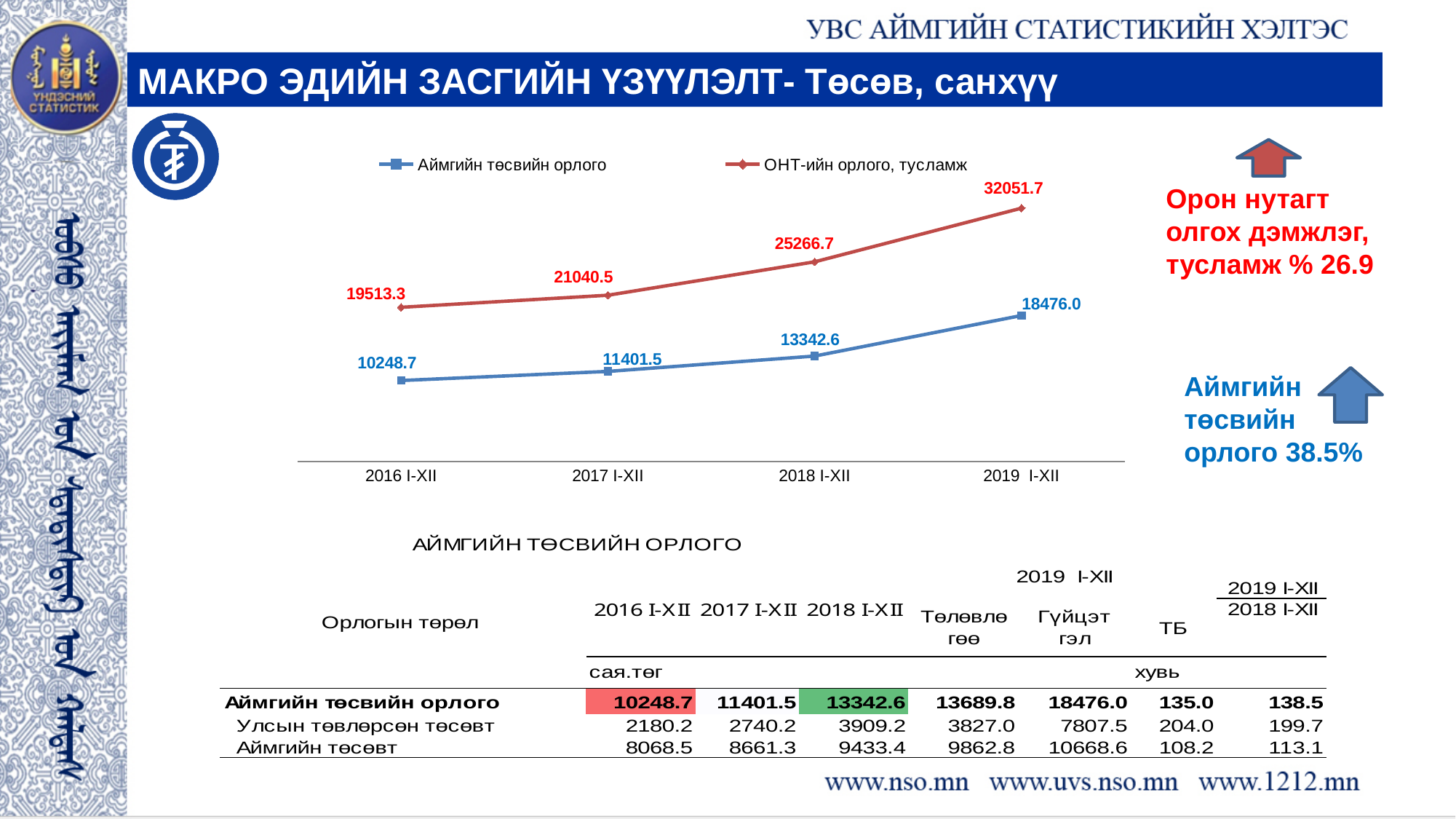
What type of chart is shown on the slide? line chart Which series has the larger value in 2018 I-XII, Аймгийн төсвийн орлого or ОНТ-ийн орлого, тусламж? ОНТ-ийн орлого, тусламж What is the value of Аймгийн төсвийн орлого for 2016 I-XII? 10248.7 What is the value of ОНТ-ийн орлого, тусламж for 2017 I-XII? 21040.5 What is the value of ОНТ-ийн орлого, тусламж for 2019 I-XII? 32051.7 What is the value of Аймгийн төсвийн орлого for 2018 I-XII? 13342.6 What is the difference between ОНТ-ийн орлого, тусламж and Аймгийн төсвийн орлого in 2019 I-XII? 13575.7 Does Аймгийн төсвийн орлого rise or fall from 2016 I-XII to 2019 I-XII? rise In which period is Аймгийн төсвийн орлого highest? 2019 I-XII How many periods are plotted along the x axis of the chart? 4 In which period is ОНТ-ийн орлого, тусламж lowest? 2016 I-XII How many series does the chart legend list? 2